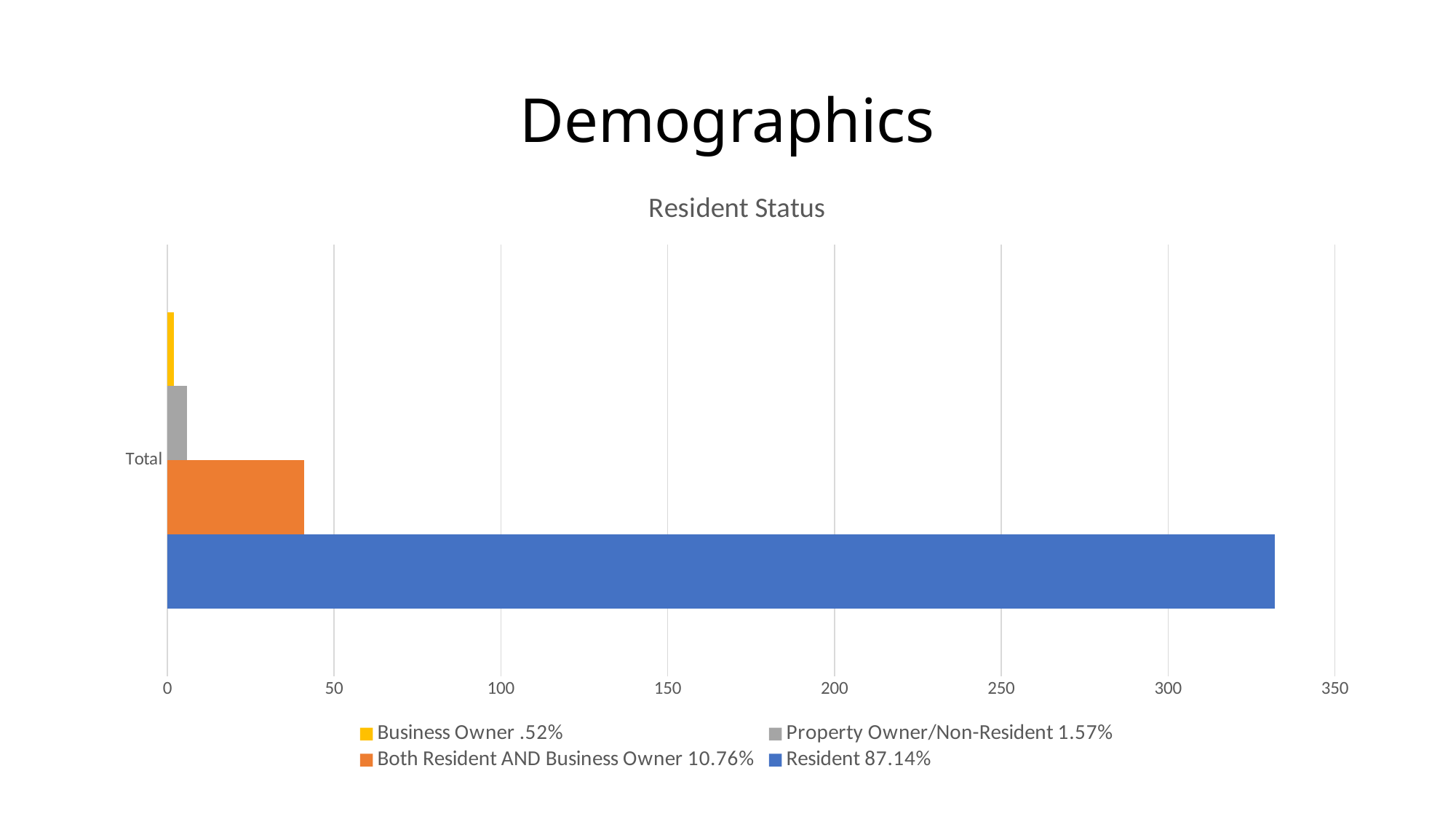
Is the value for Both Resident AND Business Owner greater or less than 50? less Which is larger, the bar for Resident or the bar for Both Resident AND Business Owner? Resident Which series has the shortest bar? Business Owner .52% Which series has the longest bar? Resident 87.14% What is the title of the chart? Resident Status Is the value for Property Owner/Non-Resident greater or less than 50? less How many series does the legend list? 4 What type of chart is shown on the slide? bar chart Is the value for Resident greater or less than 300? greater Which is larger, the bar for Both Resident AND Business Owner or the bar for Property Owner/Non-Resident? Both Resident AND Business Owner What percentage does the legend give for Property Owner/Non-Resident? 1.57% How many categories are shown on the vertical axis? 1